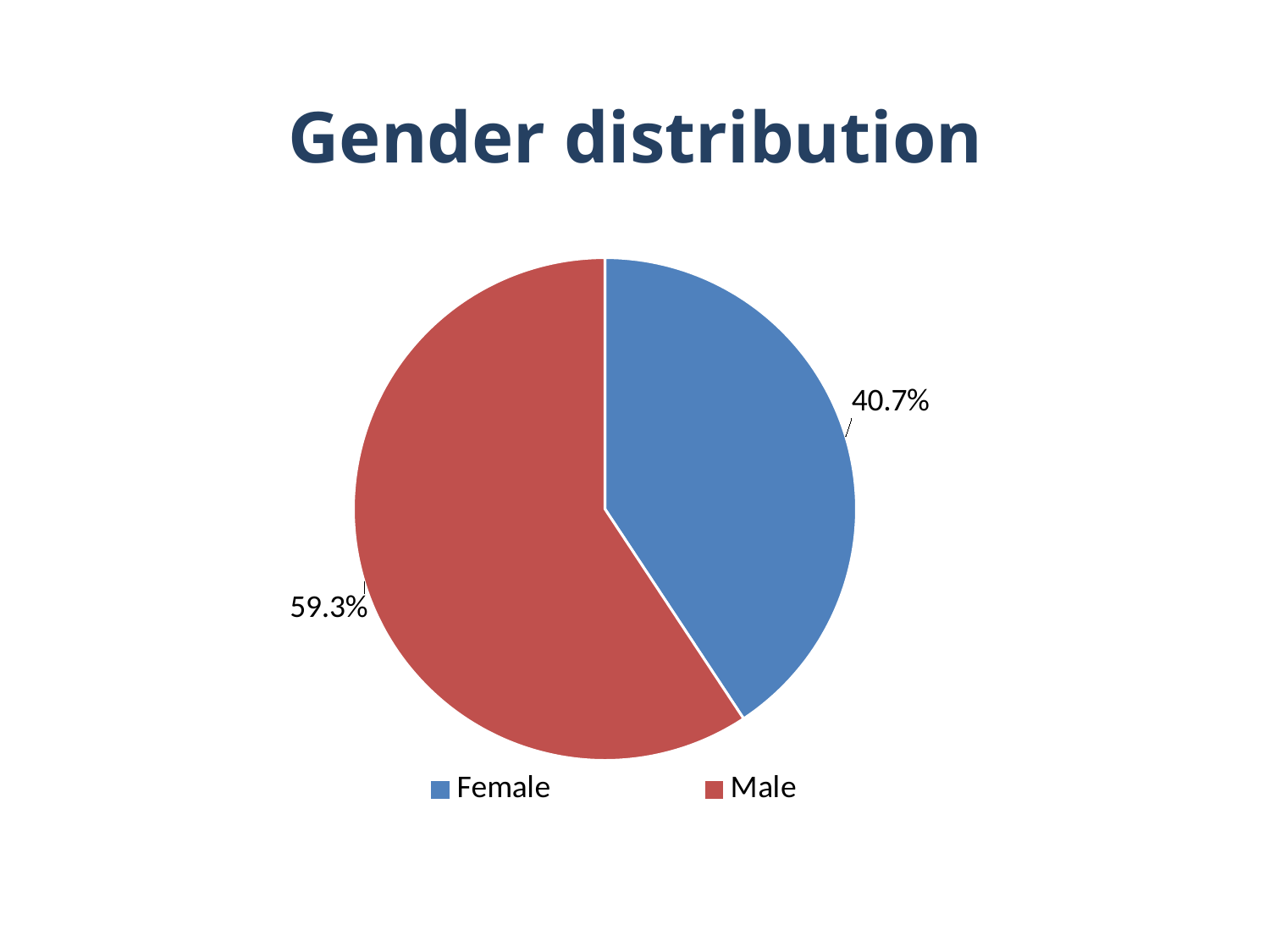
What percentage of the pie chart is Female? 40.7% Which is larger, the Female share or the Male share? Male Which category has the smallest share of the pie chart? Female What is the difference in percentage points between the Male and Female shares? 18.6 What colour is the Male slice of the pie chart? Red What kind of chart is shown on the slide? Pie chart What percentage of the pie chart is Male? 59.3% Is the Male share greater or less than 50%? greater What is the share of the pie represented by the Female slice? 40.7% Which category has the largest share of the pie chart? Male How many categories are shown in the pie chart? 2 What is the title of the chart? Gender distribution